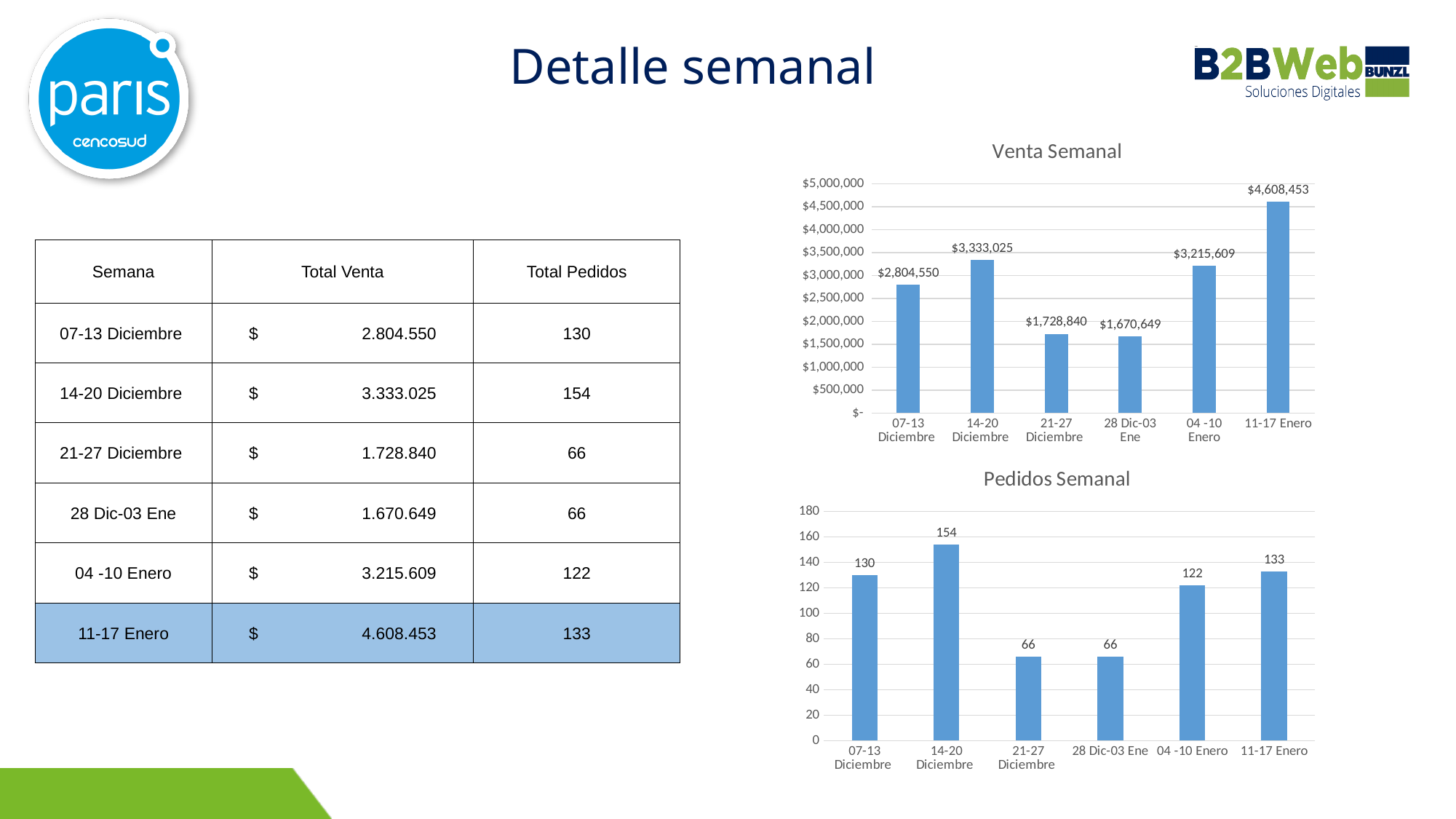
In the Venta Semanal chart, which week has the highest value? 11-17 Enero What type of chart is the Pedidos Semanal chart? Bar chart In the Venta Semanal chart, how many weeks are plotted? 6 In the Pedidos Semanal chart, what is the difference between 14-20 Diciembre and 21-27 Diciembre? 88 In the Venta Semanal chart, what is the value for 11-17 Enero? $4,608,453 In the Pedidos Semanal chart, what is the value for 04 -10 Enero? 122 In the Venta Semanal chart, which week has the lowest value? 28 Dic-03 Ene In the Pedidos Semanal chart, which week has the highest value? 14-20 Diciembre In the Pedidos Semanal chart, which is larger, 07-13 Diciembre or 11-17 Enero? 11-17 Enero In the Venta Semanal chart, what is the difference between 14-20 Diciembre and 07-13 Diciembre? $528,475 In the Venta Semanal chart, what is the value for 21-27 Diciembre? $1,728,840 In the Pedidos Semanal chart, what is the value for 14-20 Diciembre? 154